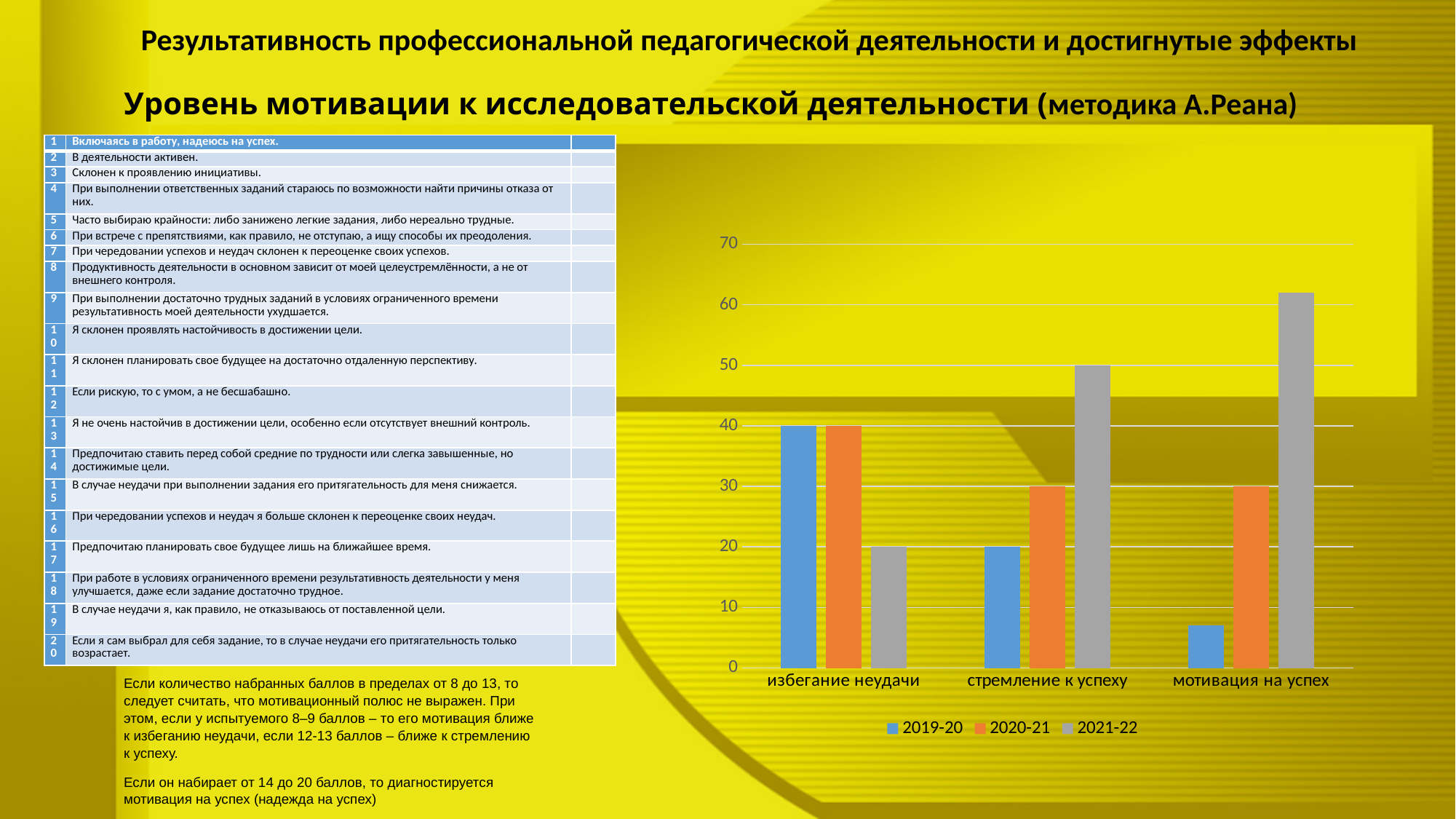
What is the difference between the 2021-22 and 2019-20 values in the category стремление к успеху? 30 What is the value for 2021-22 in the category избегание неудачи? 20 Which category has the lowest value for the 2019-20 series? мотивация на успех Is the value for 2021-22 in the category мотивация на успех greater or less than 60? greater How many categories are shown on the x axis of the chart? 3 Which category has the highest value for the 2021-22 series? мотивация на успех What is the value for 2019-20 in the category избегание неудачи? 40 Is the value for 2019-20 in the category мотивация на успех greater or less than 10? less What is the value for 2021-22 in the category стремление к успеху? 50 How many series does the chart legend list? 3 What is the value for 2020-21 in the category мотивация на успех? 30 What kind of chart is shown on the slide? bar chart